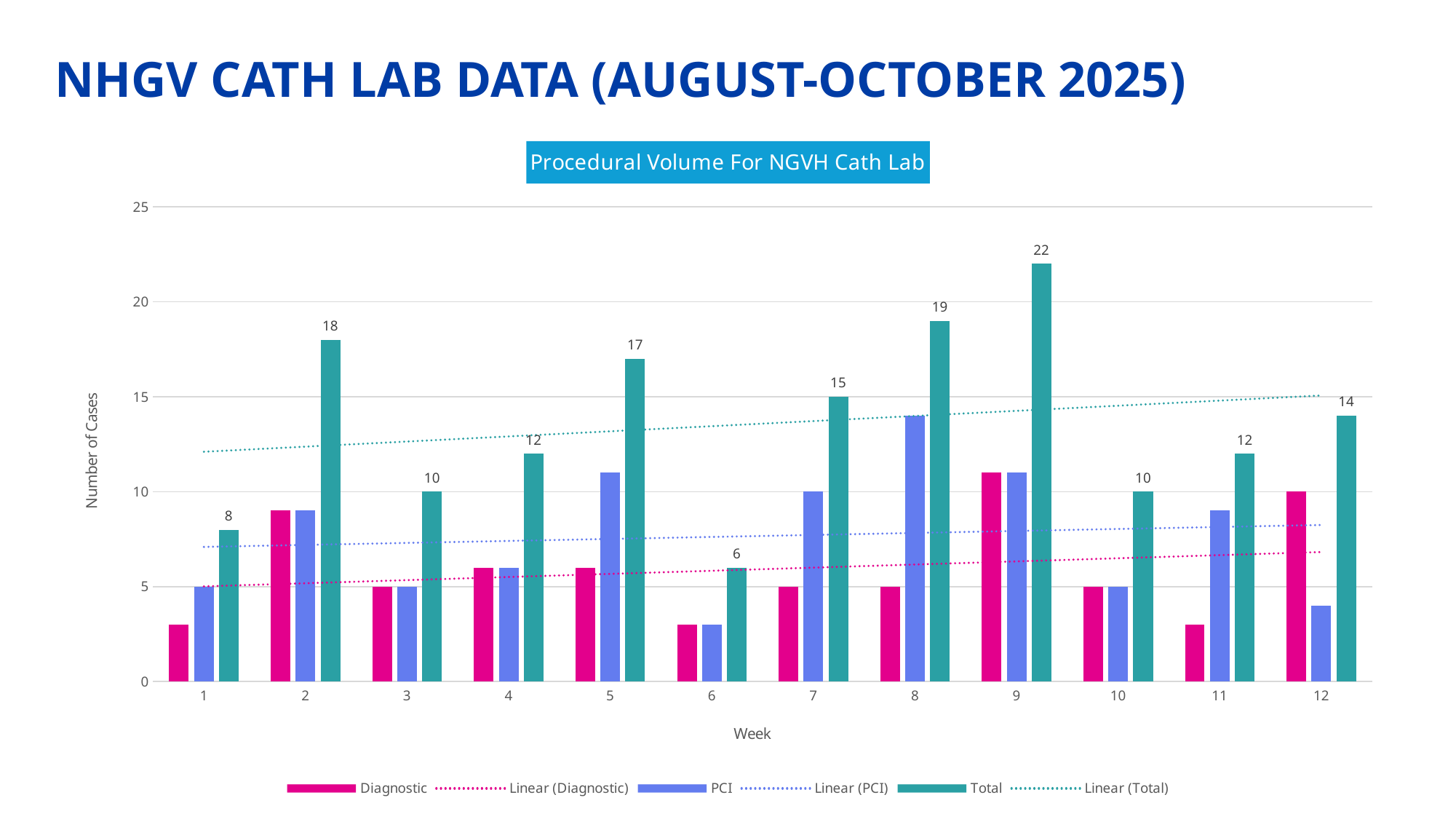
Which is larger, the Total for week 2 or the Total for week 5? Week 2 What kind of chart is used to show the procedural volume? Bar chart Is the PCI value for week 8 greater or less than 10? greater How many entries does the legend list? 6 Does the Linear (Total) trendline rise or fall from week 1 to week 12? Rises What is the Total number of cases in week 9? 22 What is the Total number of cases in week 2? 18 What is the difference between the Total cases in week 8 and week 6? 13 Which week has the highest Total number of cases? Week 9 Is the Diagnostic value for week 1 greater or less than 5? less Which week has the lowest Total number of cases? Week 6 How many weeks are shown on the x axis? 12